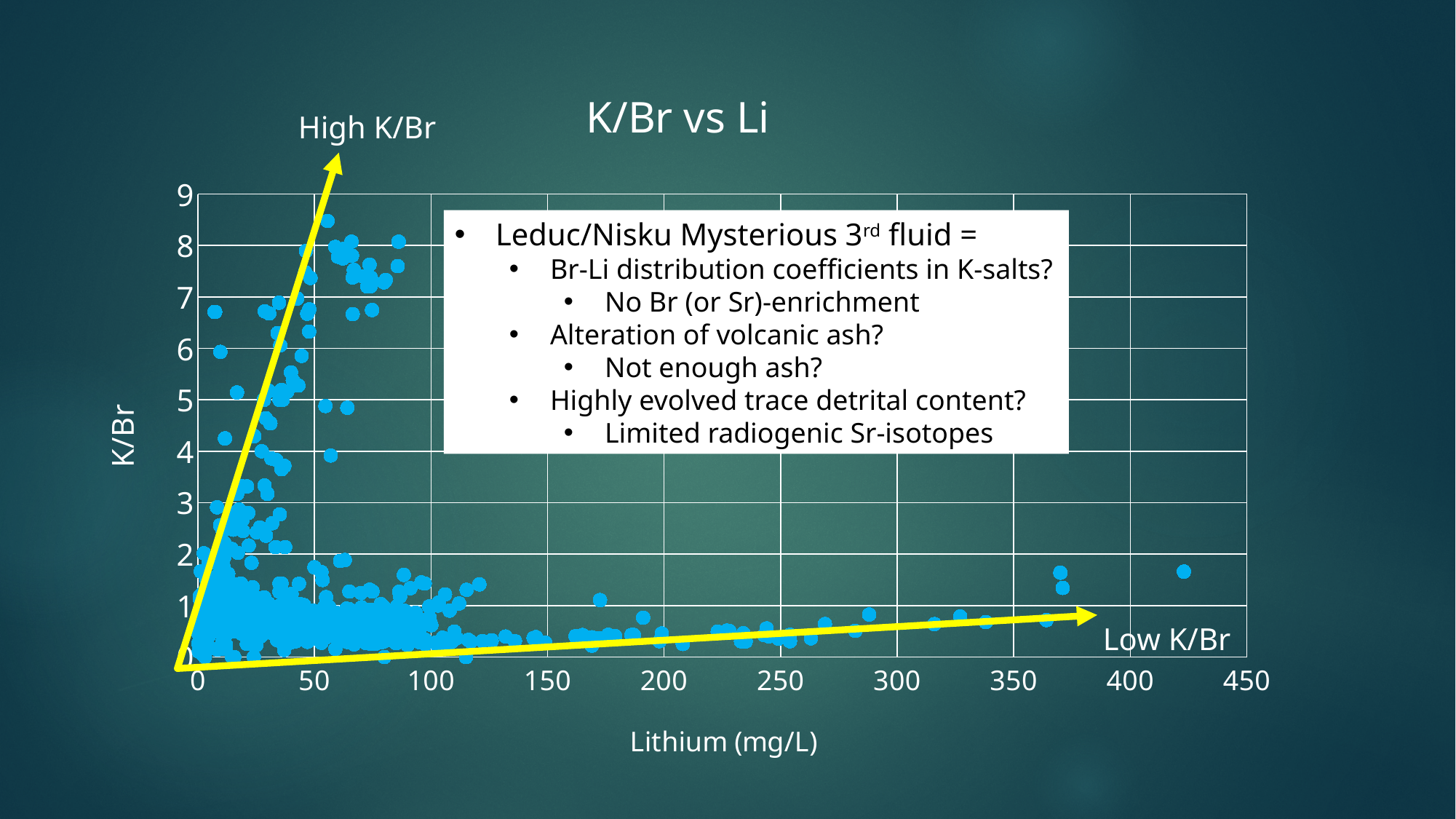
What kind of chart is shown on the slide? scatter chart What is the label of the x axis? Lithium (mg/L) What is the title of the chart? K/Br vs Li Which region of the chart does the steep yellow arrow point toward, according to its label? High K/Br Do the points with lithium above 150 mg/L mostly have K/Br values greater or less than 2? less Is the lithium value of the highest K/Br point greater or less than 100 mg/L? less Does K/Br generally rise or fall as lithium increases beyond about 100 mg/L? rise Is the K/Br value of the rightmost point (at roughly 425 mg/L lithium) greater or less than 2? less